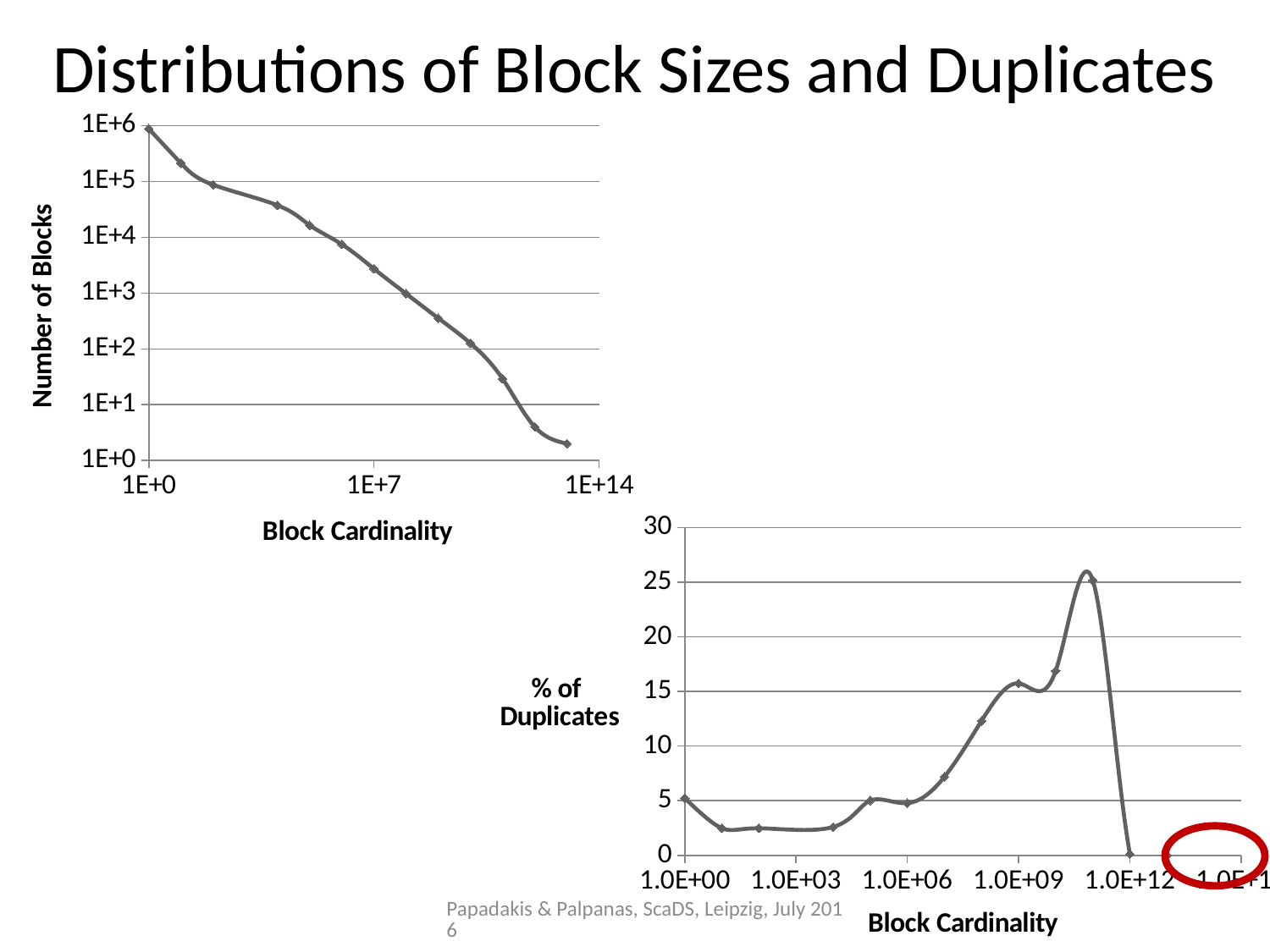
What is the x-axis title of the bottom-right chart? Block Cardinality In the bottom-right chart (% of Duplicates), is the peak value greater or less than 20? greater In the top-left chart (Number of Blocks), do the values rise or fall as Block Cardinality increases along the x axis? fall What kind of chart is the top-left chart showing Number of Blocks against Block Cardinality? line chart What is the y-axis title of the top-left chart? Number of Blocks What kind of chart is the bottom-right chart showing % of Duplicates against Block Cardinality? line chart In the top-left chart (Number of Blocks), is the value at the rightmost point greater or less than 1E+1? less In the top-left chart (Number of Blocks), is the value at Block Cardinality 1E+7 greater or less than 1E+4? less In the bottom-right chart (% of Duplicates), which is larger: the value at Block Cardinality 1.0E+09 or the value at 1.0E+03? 1.0E+09